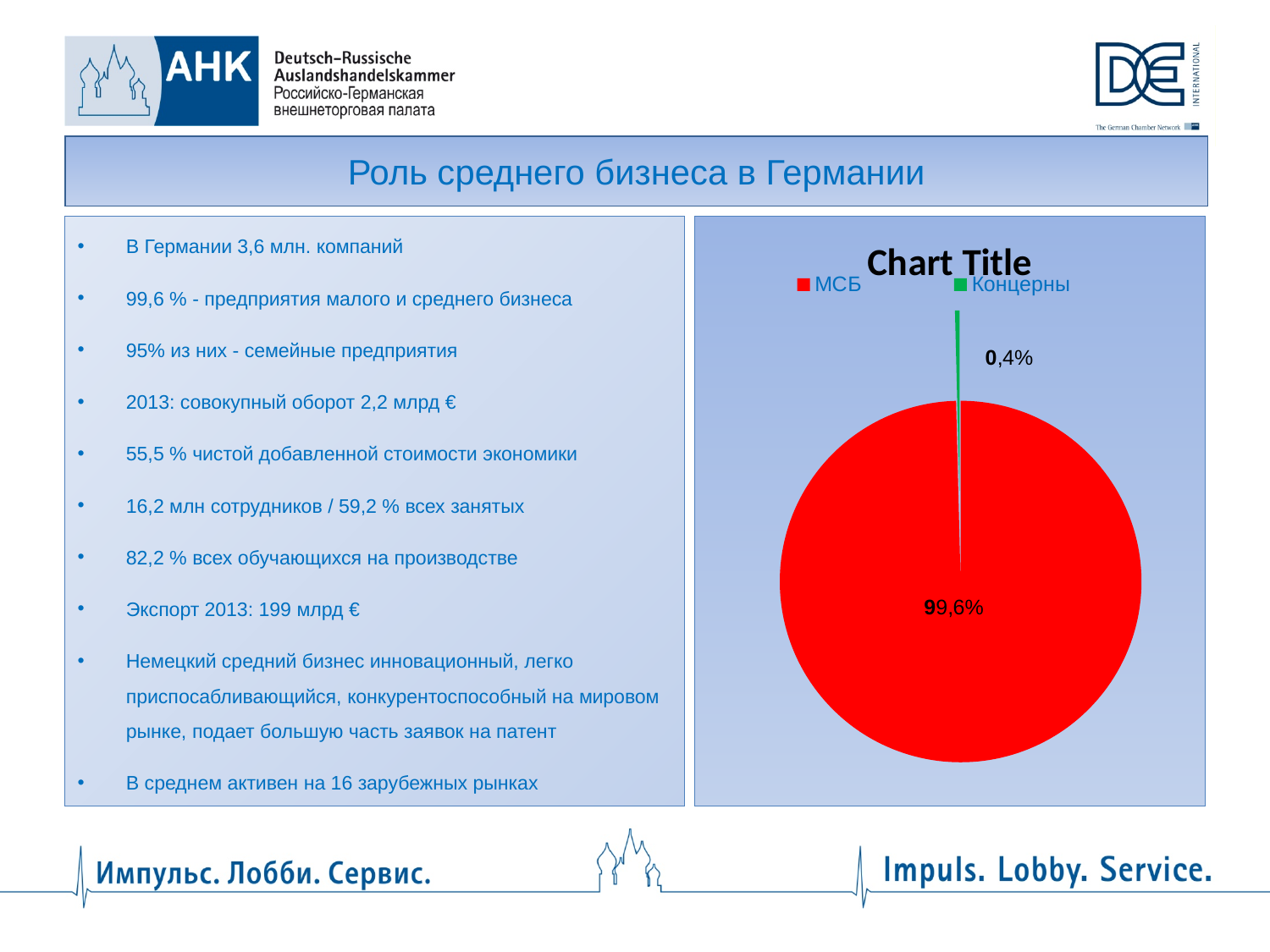
What colour is the МСБ slice in the pie chart? red What is the title of the pie chart? Chart Title What share of the pie does МСБ take? 99,6% How many slices does the pie chart have? 2 Which is larger in the pie chart, МСБ or Концерны? МСБ Which category has the largest slice in the pie chart? МСБ What kind of chart is shown on the slide? pie chart What is the value shown for МСБ in the pie chart? 99,6% How many entries does the legend of the pie chart list? 2 What is the difference between the МСБ and Концерны shares in the pie chart? 99,2% What is the value shown for Концерны in the pie chart? 0,4% Which category has the smallest slice in the pie chart? Концерны